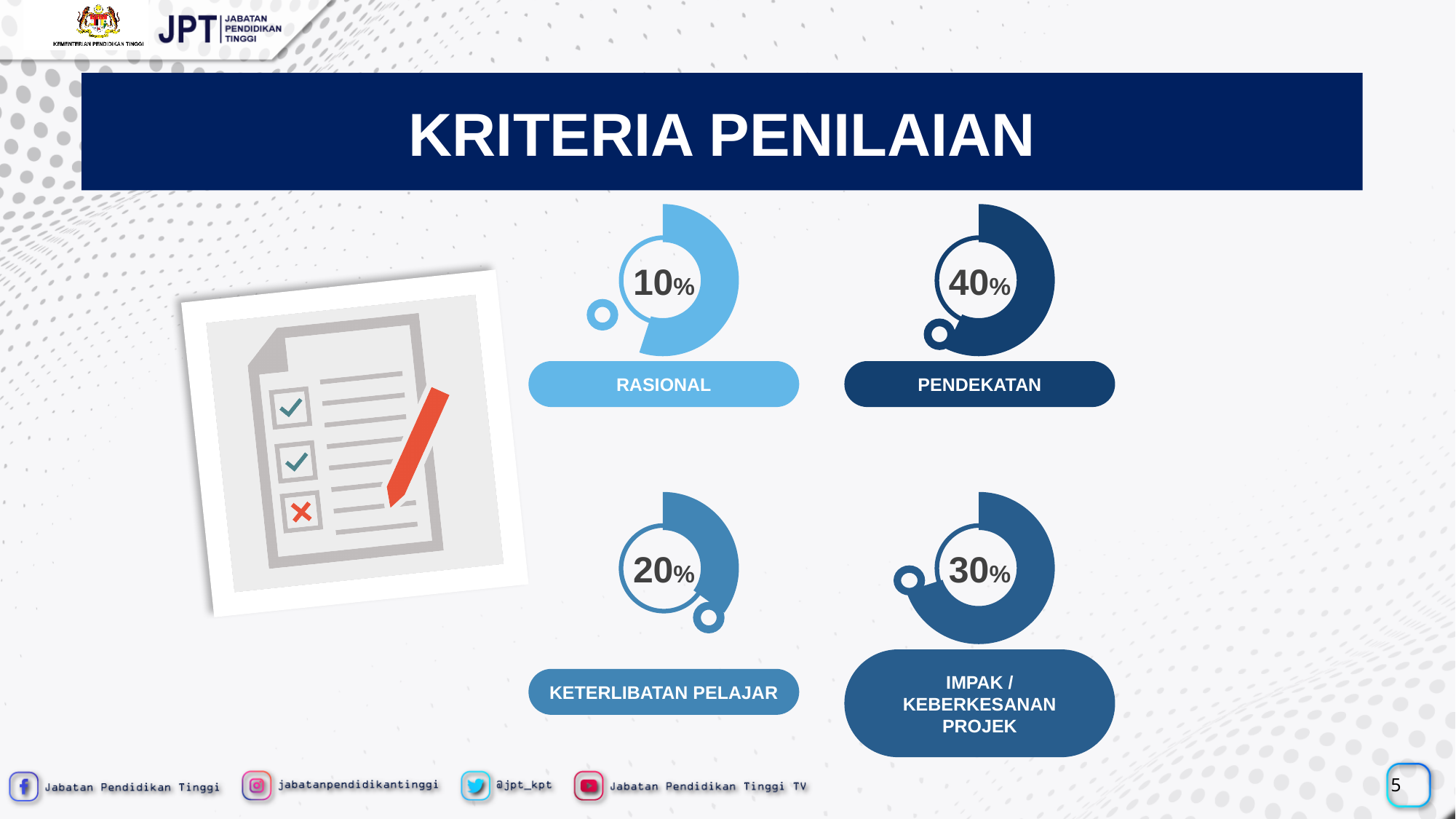
What percentage is shown for PENDEKATAN? 40% What percentage is shown for IMPAK / KEBERKESANAN PROJEK? 30% Which criterion has the lowest percentage? RASIONAL What is the title of the slide containing the percentage charts? KRITERIA PENILAIAN Which has a larger percentage, KETERLIBATAN PELAJAR or IMPAK / KEBERKESANAN PROJEK? IMPAK / KEBERKESANAN PROJEK What percentage is shown for KETERLIBATAN PELAJAR? 20% What is the total of the four percentages shown on the slide? 100% What is the difference between the percentages for IMPAK / KEBERKESANAN PROJEK and KETERLIBATAN PELAJAR? 10% Which criterion has the highest percentage? PENDEKATAN What percentage is shown for RASIONAL? 10% What is the difference between the percentages for PENDEKATAN and RASIONAL? 30% How many evaluation criteria are shown with percentage charts on the slide? 4